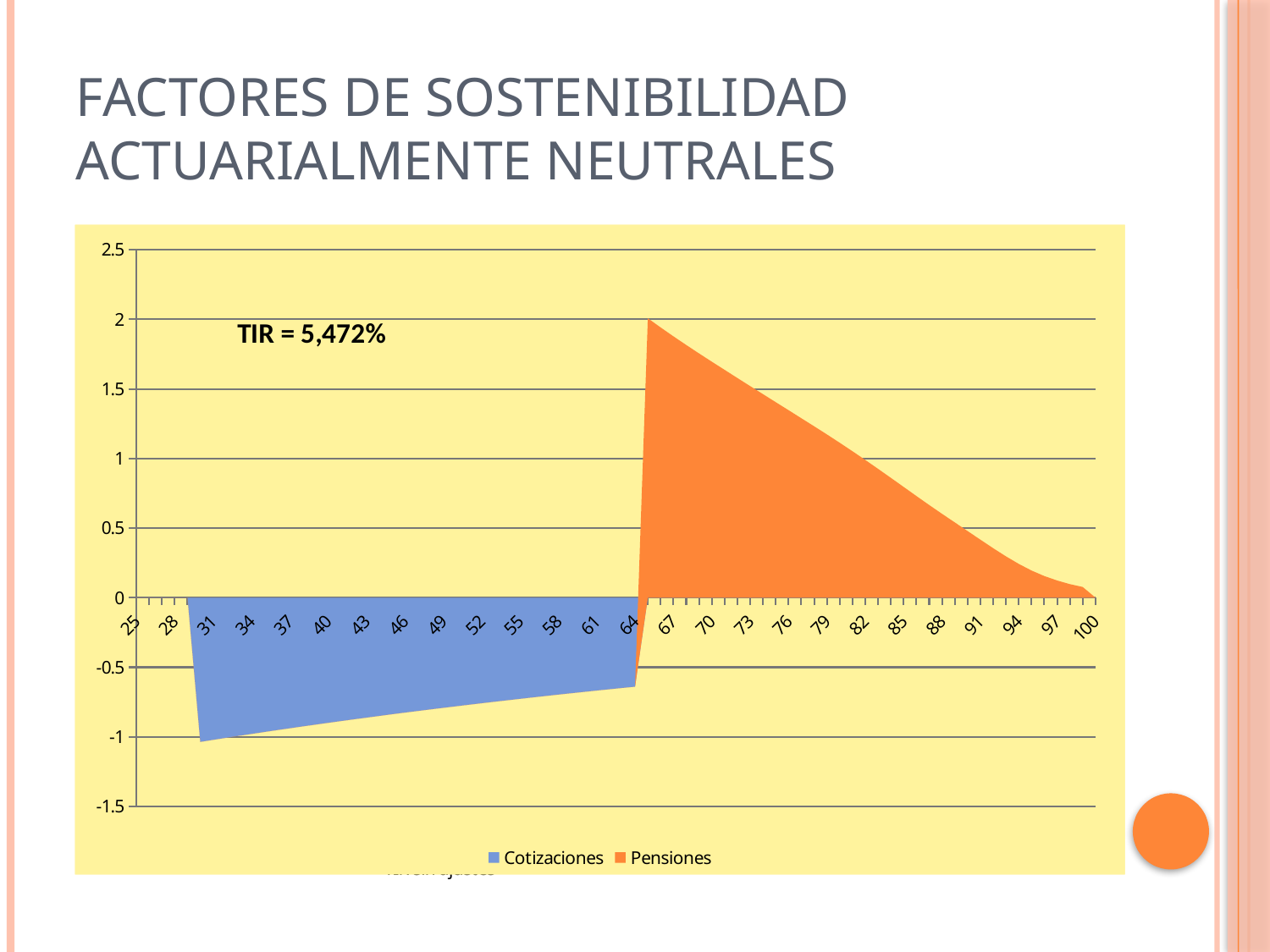
Is the value of Pensiones at age 97 greater or less than 0.5? less What TIR value is annotated on the chart? TIR = 5,472% Is the value of Cotizaciones at age 64 greater or less than -1? greater How many series does the legend list? 2 What are the two series named in the legend? Cotizaciones and Pensiones What kind of chart is shown on the slide? Area chart Which is larger, the Pensiones value at age 67 or at age 97? Age 67 Is the value of Pensiones at age 67 greater or less than 1.5? greater Do the Pensiones values rise or fall from age 67 to age 100? fall Which series is plotted with negative values, Cotizaciones or Pensiones? Cotizaciones